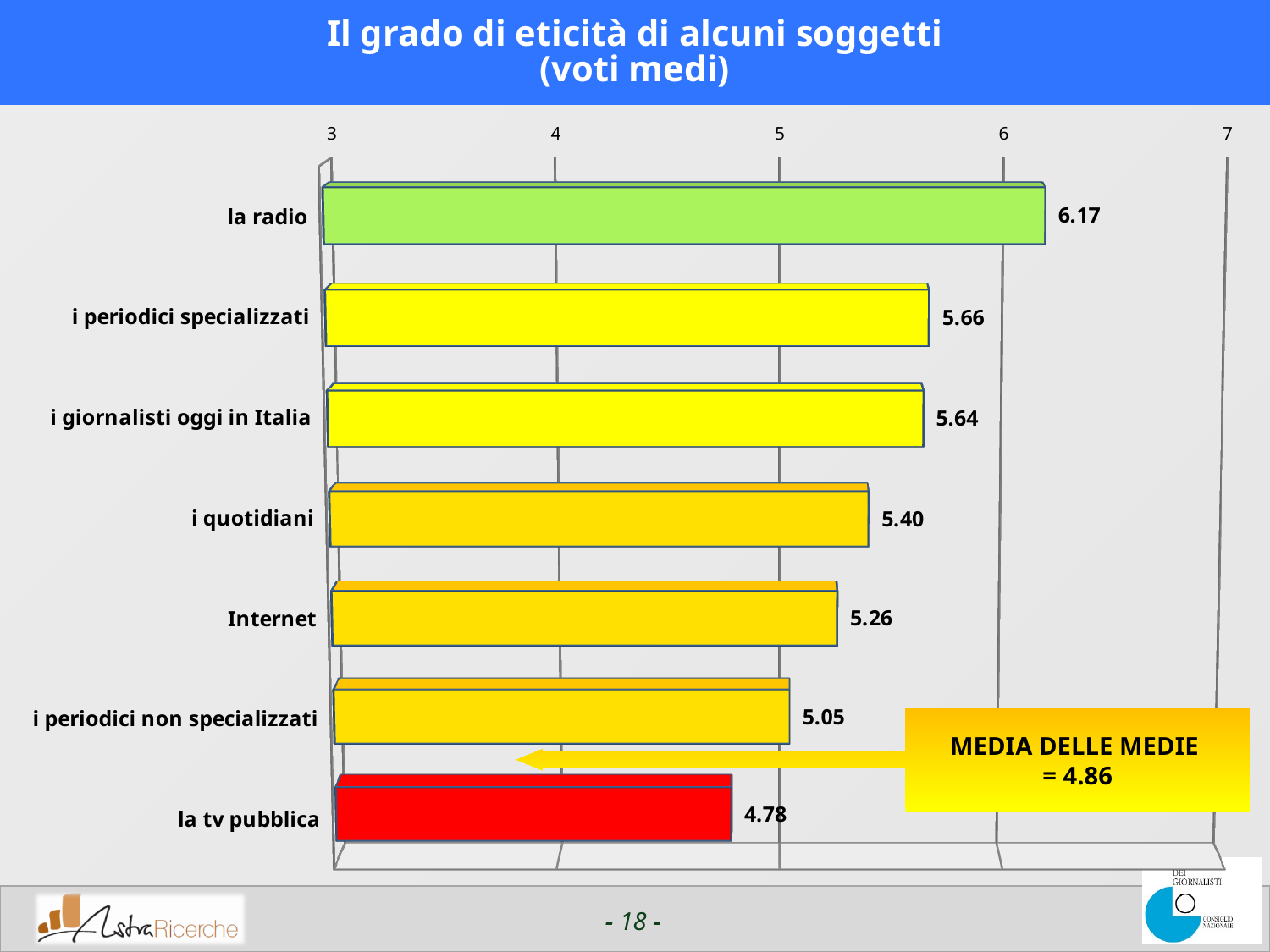
What is the 'media delle medie' value shown in the callout box? 4.86 What kind of chart is shown on the slide? bar chart Which category has the lowest value? la tv pubblica How many categories are shown in the chart? 7 What is the value for i giornalisti oggi in Italia? 5.64 Which is larger, the value for i quotidiani or the value for i periodici non specializzati? i quotidiani What is the difference between the values for la radio and la tv pubblica? 1.39 What is the difference between the values for i quotidiani and Internet? 0.14 What is the value for la tv pubblica? 4.78 What is the value for la radio? 6.17 Which category has the highest value? la radio Is the value for la tv pubblica greater or less than 5? less